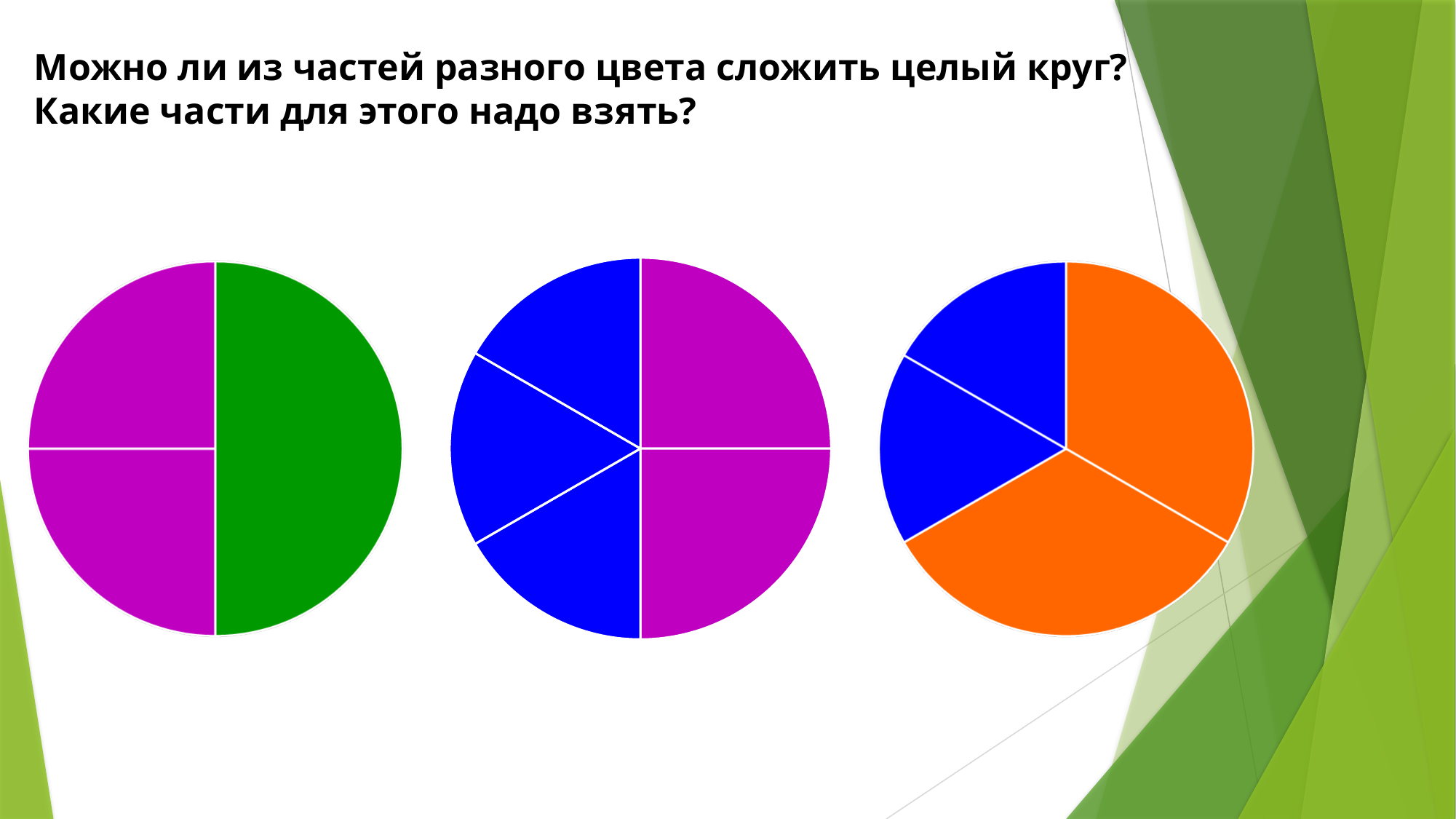
In the middle chart, how many slices is the circle divided into? 5 What kind of chart is the leftmost chart on the slide? pie chart Which two colours are used in the middle chart? blue and purple In the rightmost chart, how many slices is the circle divided into? 4 In the leftmost chart, how many slices is the circle divided into? 3 In the rightmost chart, which colour covers the larger part of the circle, blue or orange? orange Which two colours are used in the leftmost chart? purple and green